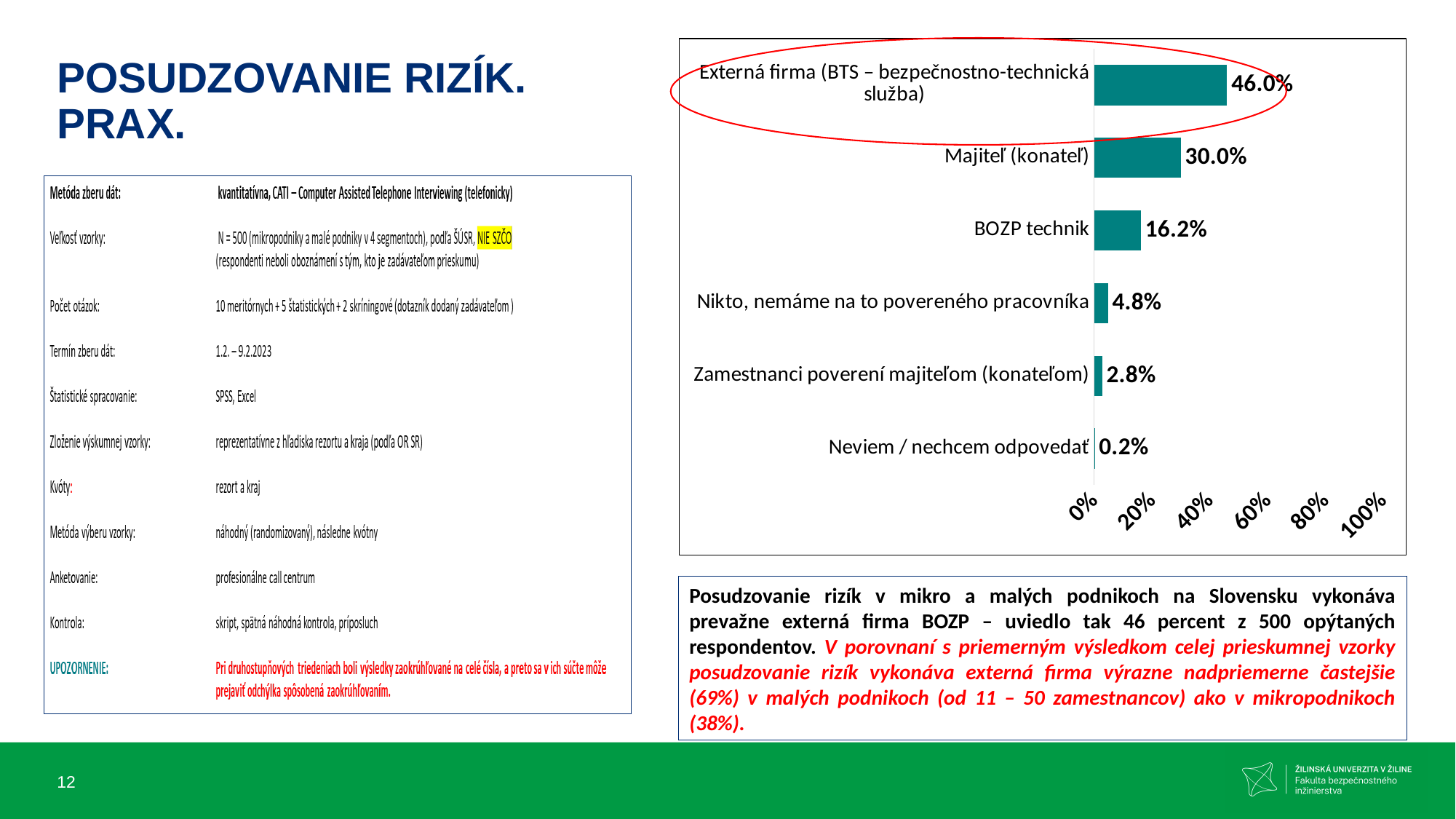
Is the value for Majiteľ (konateľ) greater or less than 20%? greater What is the difference between the values for Externá firma (BTS – bezpečnostno-technická služba) and Majiteľ (konateľ)? 16.0% Which category has the lowest value? Neviem / nechcem odpovedať Which category has the highest value? Externá firma (BTS – bezpečnostno-technická služba) What kind of chart is shown on the slide? bar chart What is the value for BOZP technik? 16.2% Which is larger, the value for BOZP technik or the value for Zamestnanci poverení majiteľom (konateľom)? BOZP technik How many categories are shown in the chart? 6 What is the value for Neviem / nechcem odpovedať? 0.2% What is the value for Nikto, nemáme na to povereného pracovníka? 4.8% What is the value for Externá firma (BTS – bezpečnostno-technická služba)? 46.0% What is the value for Majiteľ (konateľ)? 30.0%